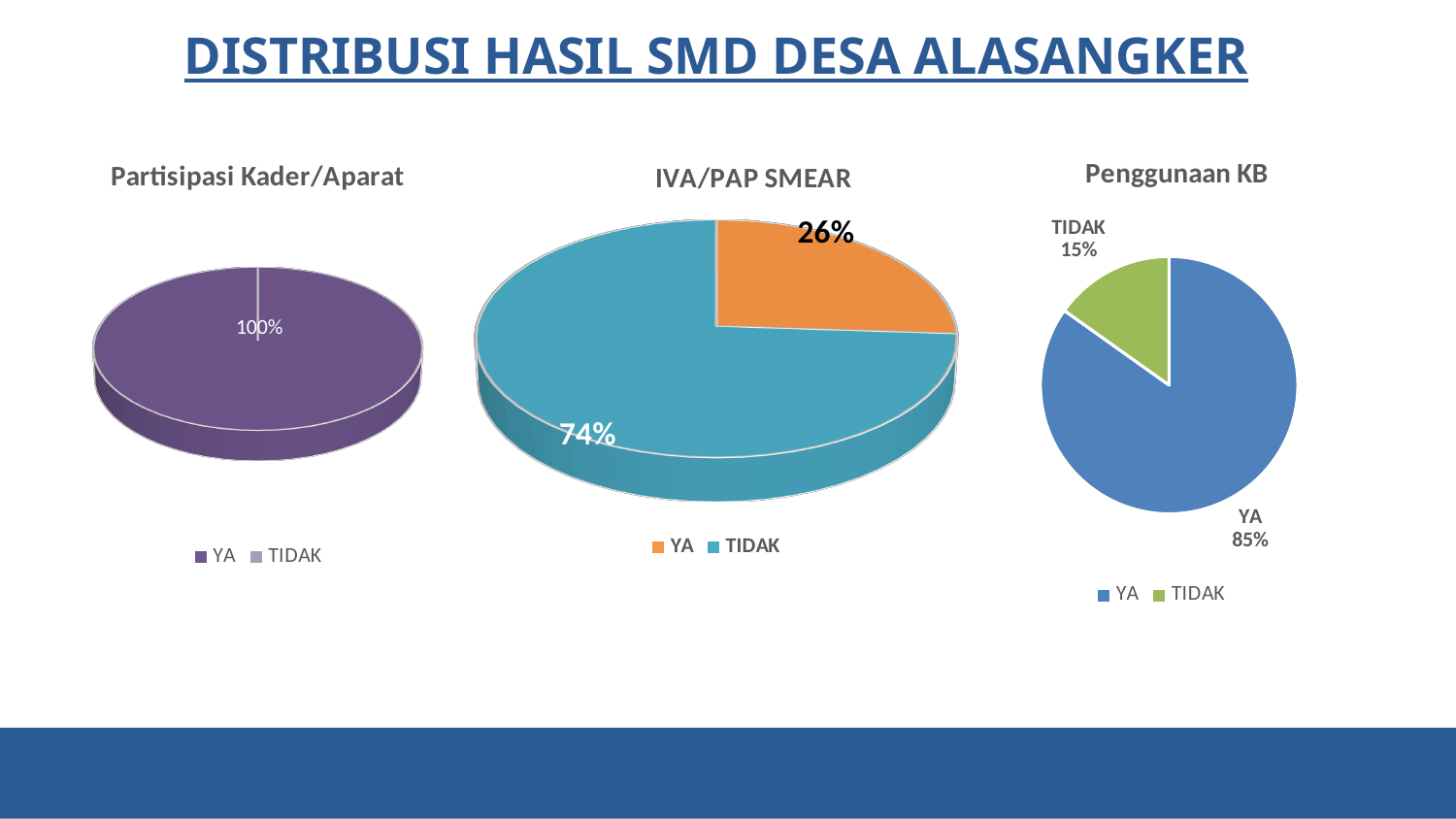
In the IVA/PAP SMEAR chart, what share is labelled for TIDAK? 74% In the Penggunaan KB chart, what percentage is shown for YA? 85% In the IVA/PAP SMEAR chart, what is the difference between the TIDAK and YA shares? 48% In the Penggunaan KB chart, which category has the smaller share? TIDAK In the Penggunaan KB chart, what is the difference between the YA and TIDAK shares? 70% How many entries does the legend of the IVA/PAP SMEAR chart list? 2 How many charts are shown on the slide? 3 In the Partisipasi Kader/Aparat chart, what percentage is printed on the pie? 100% In the Penggunaan KB chart, what percentage is shown for TIDAK? 15% What kind of chart is the Penggunaan KB chart? Pie chart In the IVA/PAP SMEAR chart, which category has the larger share? TIDAK In the IVA/PAP SMEAR chart, what share is labelled for YA? 26%